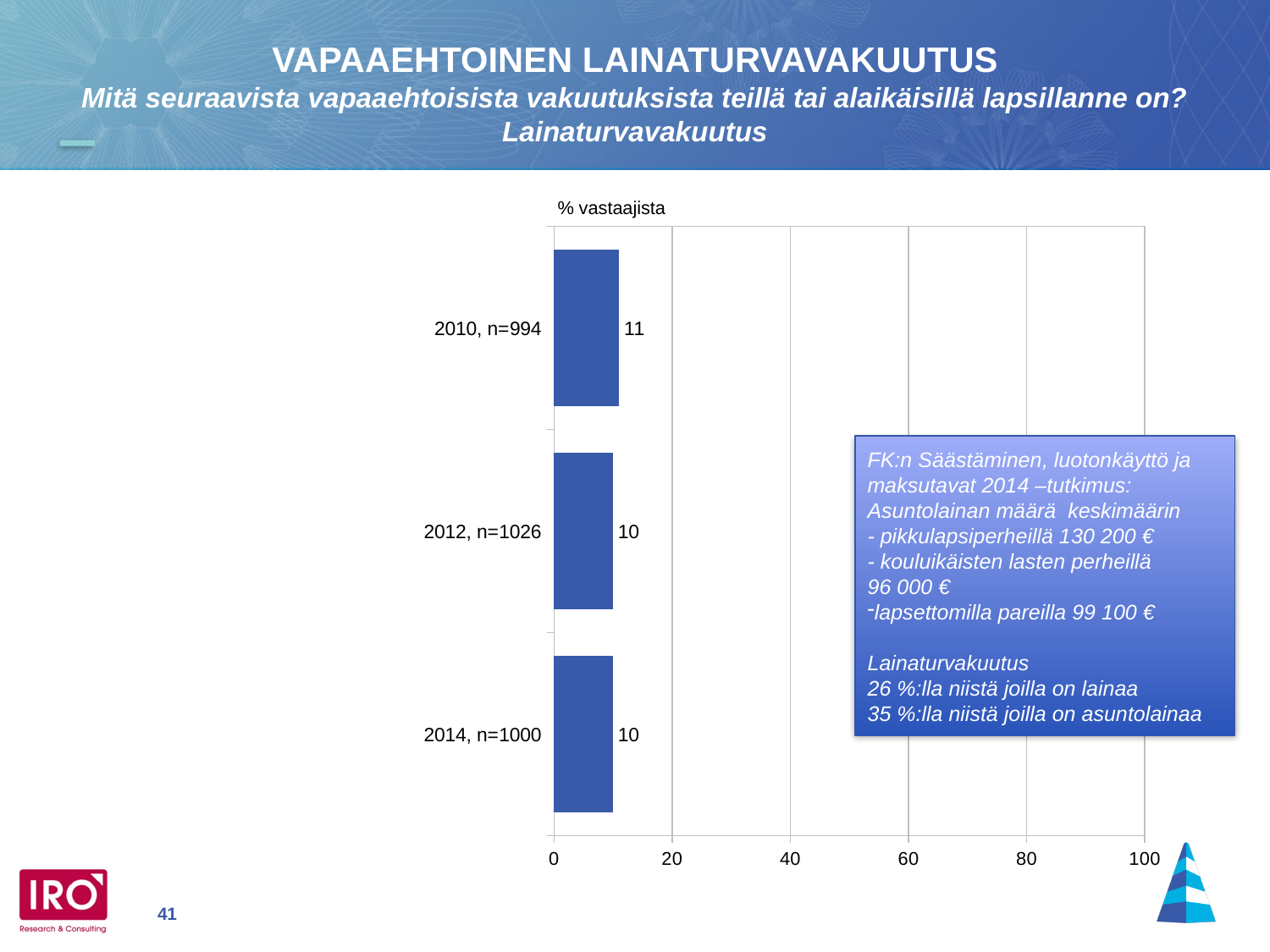
How many categories are shown in the chart? 3 Which category has the highest value? 2010, n=994 What is the value for 2012, n=1026? 10 What is the value for 2010, n=994? 11 Which is larger, the value for 2010, n=994 or the value for 2012, n=1026? 2010, n=994 What is the maximum value shown on the horizontal axis? 100 Is the value for 2014, n=1000 greater or less than 20? less What kind of chart is shown on the slide? bar chart What is the label shown above the chart's axis? % vastaajista What is the difference between the values for 2010, n=994 and 2014, n=1000? 1 What is the value for 2014, n=1000? 10 Do the values rise or fall from 2010 to 2014? fall